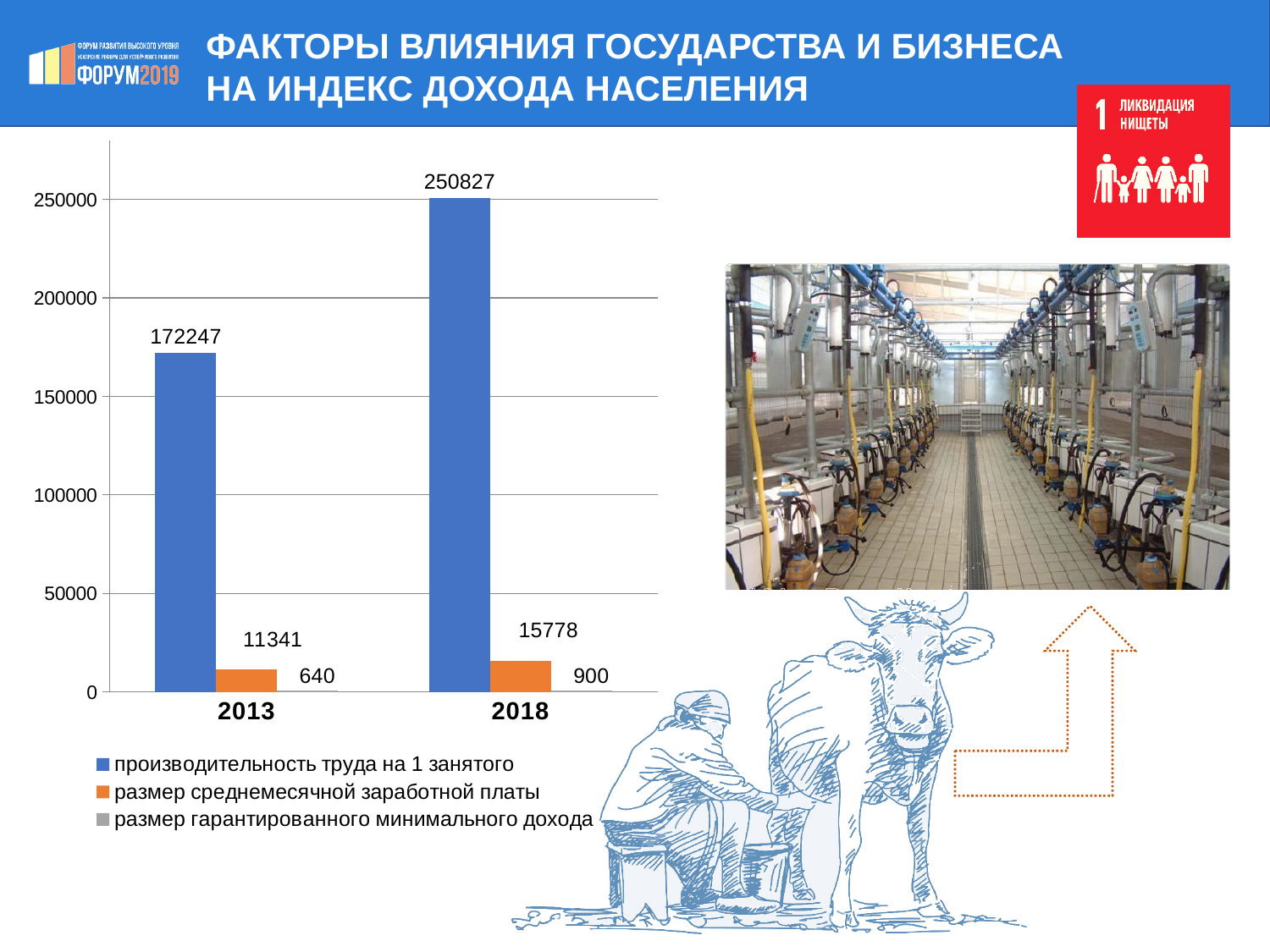
What is the value of производительность труда на 1 занятого for 2018? 250827 What is the value of размер среднемесячной заработной платы for 2013? 11341 Is the value of производительность труда на 1 занятого for 2018 greater or less than 200000? greater By how much did производительность труда на 1 занятого increase from 2013 to 2018? 78580 How many series does the chart legend list? 3 What is the difference in размер среднемесячной заработной платы between 2018 and 2013? 4437 How many categories are shown on the x axis of the chart? 2 Which year has the higher value for размер гарантированного минимального дохода, 2013 or 2018? 2018 What is the value of размер среднемесячной заработной платы for 2018? 15778 What is the value of размер гарантированного минимального дохода for 2018? 900 What is the value of производительность труда на 1 занятого for 2013? 172247 What type of chart is shown on the slide? bar chart